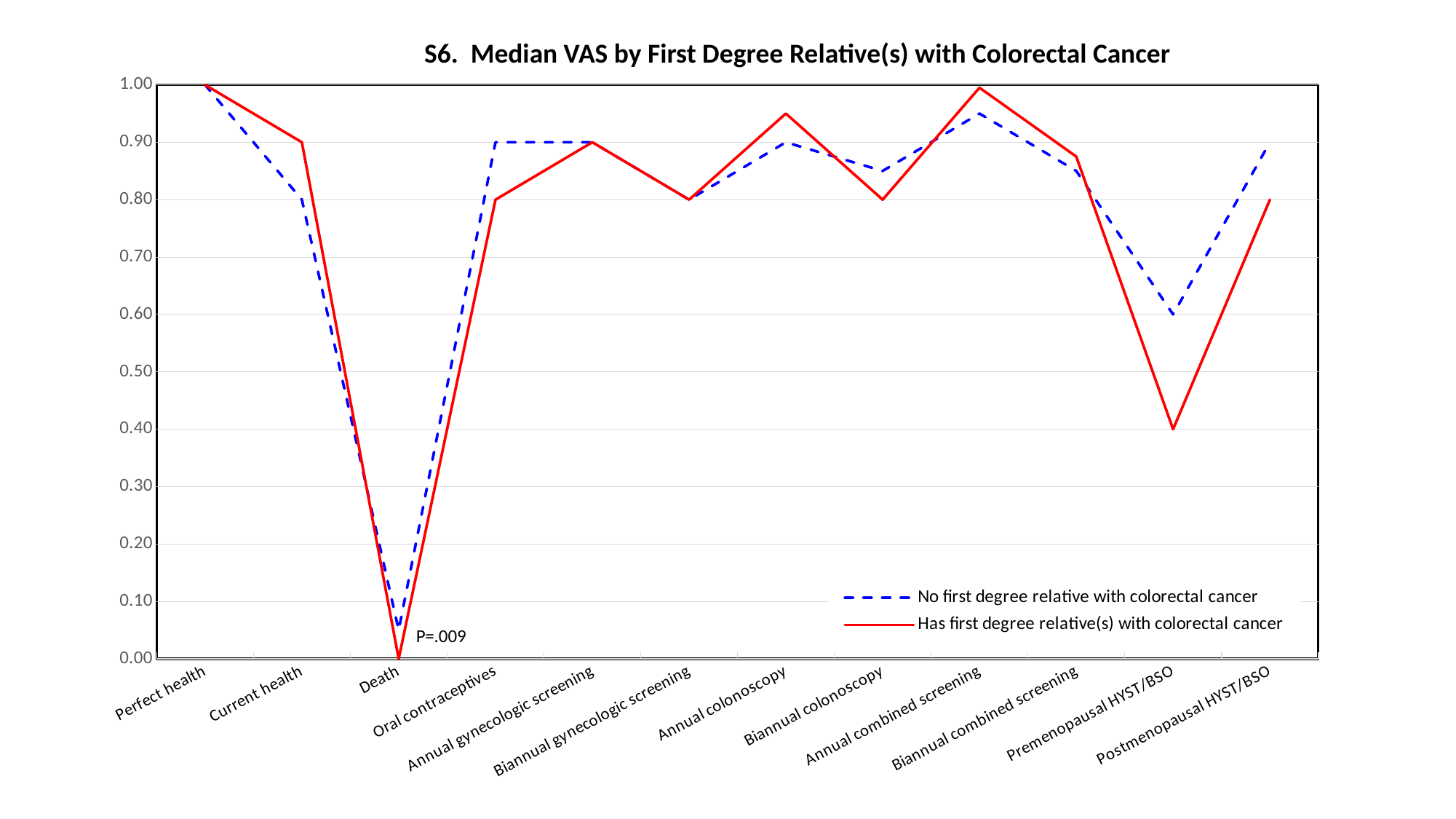
What is the median VAS for Premenopausal HYST/BSO for the 'Has first degree relative(s) with colorectal cancer' series? 0.40 How many categories are shown on the x axis? 12 What is the median VAS for Current health for the 'Has first degree relative(s) with colorectal cancer' series? 0.90 Which series is drawn with a dashed blue line? No first degree relative with colorectal cancer What type of chart is shown on the slide? line chart What P value is annotated on the chart? P=.009 What is the median VAS for Death for the 'Has first degree relative(s) with colorectal cancer' series? 0.00 Is the median VAS for Annual colonoscopy for the 'Has first degree relative(s) with colorectal cancer' series greater or less than 0.90? greater Which category has the lowest median VAS for the 'Has first degree relative(s) with colorectal cancer' series? Death What is the median VAS for Premenopausal HYST/BSO for the 'No first degree relative with colorectal cancer' series? 0.60 How many series does the legend list? 2 For Premenopausal HYST/BSO, which series has the larger median VAS? No first degree relative with colorectal cancer